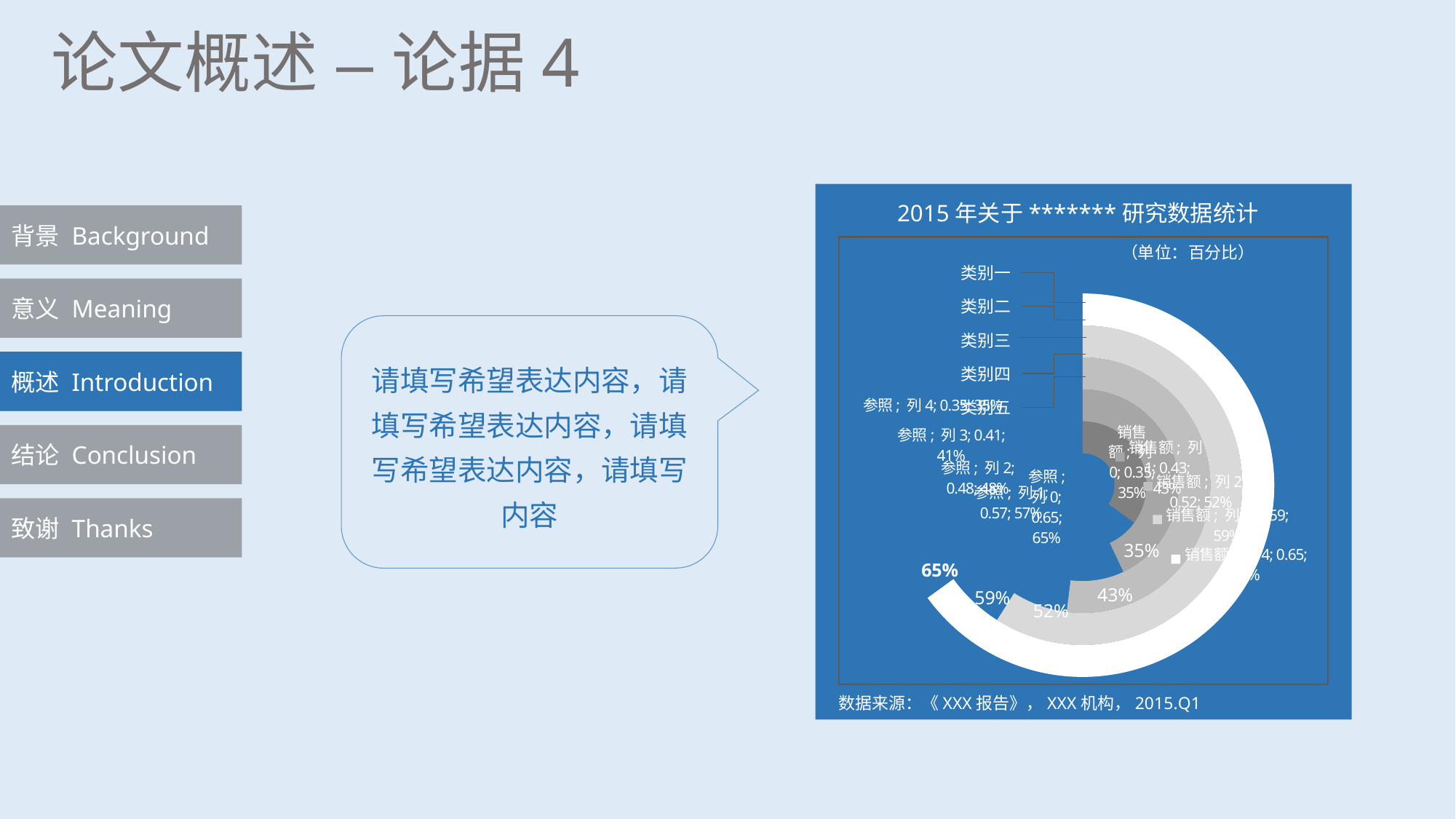
What percentage is shown in the data label for 参照 列 3? 41% What percentage is shown in the data label for 销售额 列 3? 59% What percentage is shown in the data label for 参照 列 2? 48% What unit does the chart state its values are in? 百分比 What percentage is shown in the data label for 参照 列 1? 57% Which is larger, the 销售额 列 3 value or the 参照 列 3 value? 销售额 列 3 What kind of chart is shown on the slide? doughnut chart What is the title of the chart? 2015 年关于 ******* 研究数据统计 What is the difference between the 销售额 列 3 value (59%) and the 参照 列 3 value (41%)? 18% How many categories (类别) are listed on the chart? 5 What percentage is shown in the data label for 销售额 列 2? 52%